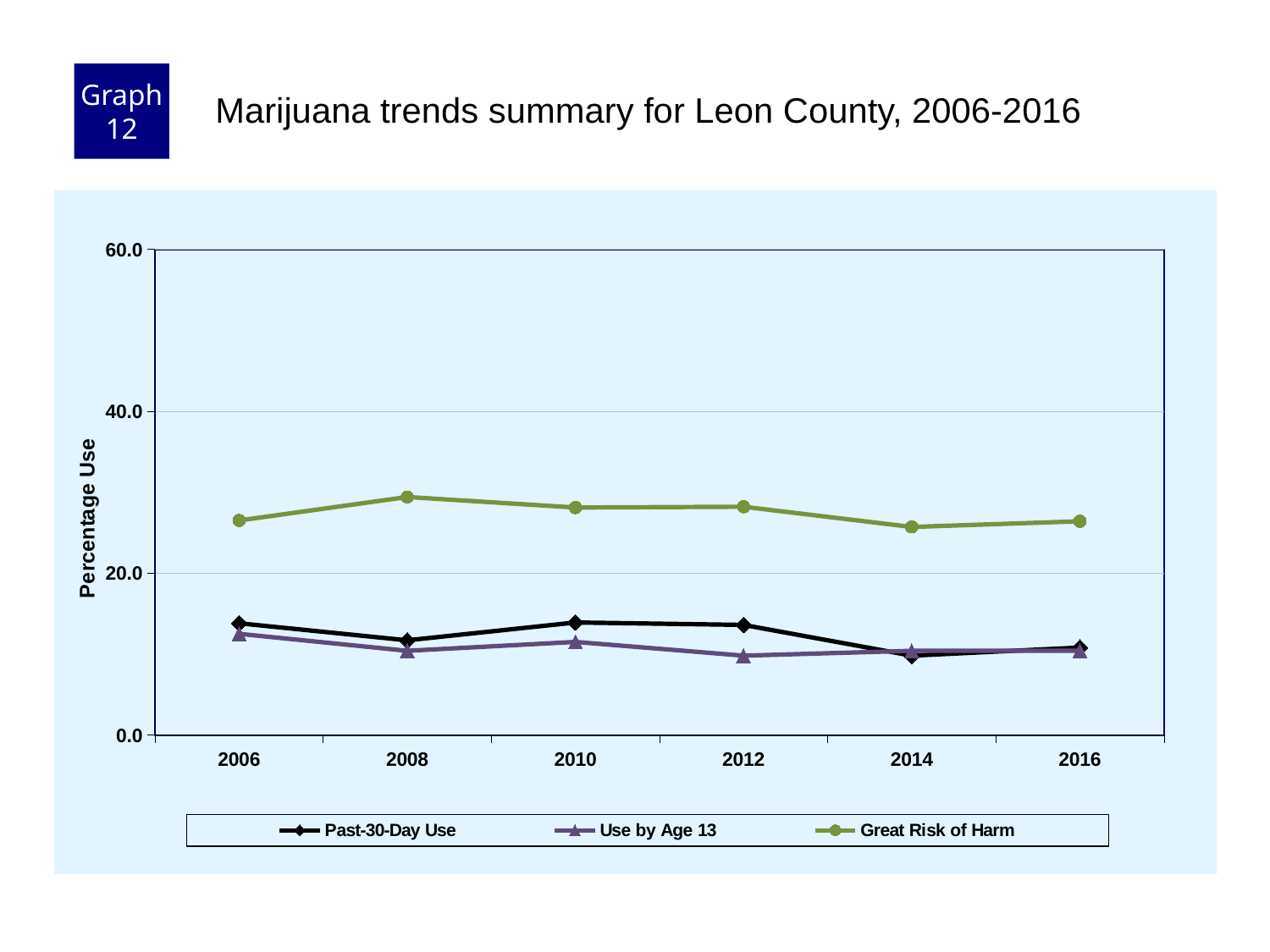
How many series does the legend list? 3 Does Great Risk of Harm rise or fall from 2012 to 2014? Fall What kind of chart is shown on the slide? Line chart Is the value for Great Risk of Harm in 2008 greater or less than 40.0? less What is the label on the y axis? Percentage Use In which year is Use by Age 13 at its highest? 2006 How many years are plotted along the x axis? 6 Is the value for Great Risk of Harm in 2014 greater or less than 20.0? greater In which year is Great Risk of Harm at its highest? 2008 In 2010, which series has the larger value: Great Risk of Harm or Past-30-Day Use? Great Risk of Harm Is the value for Past-30-Day Use in 2010 greater or less than 20.0? less In which year is Past-30-Day Use at its lowest? 2014